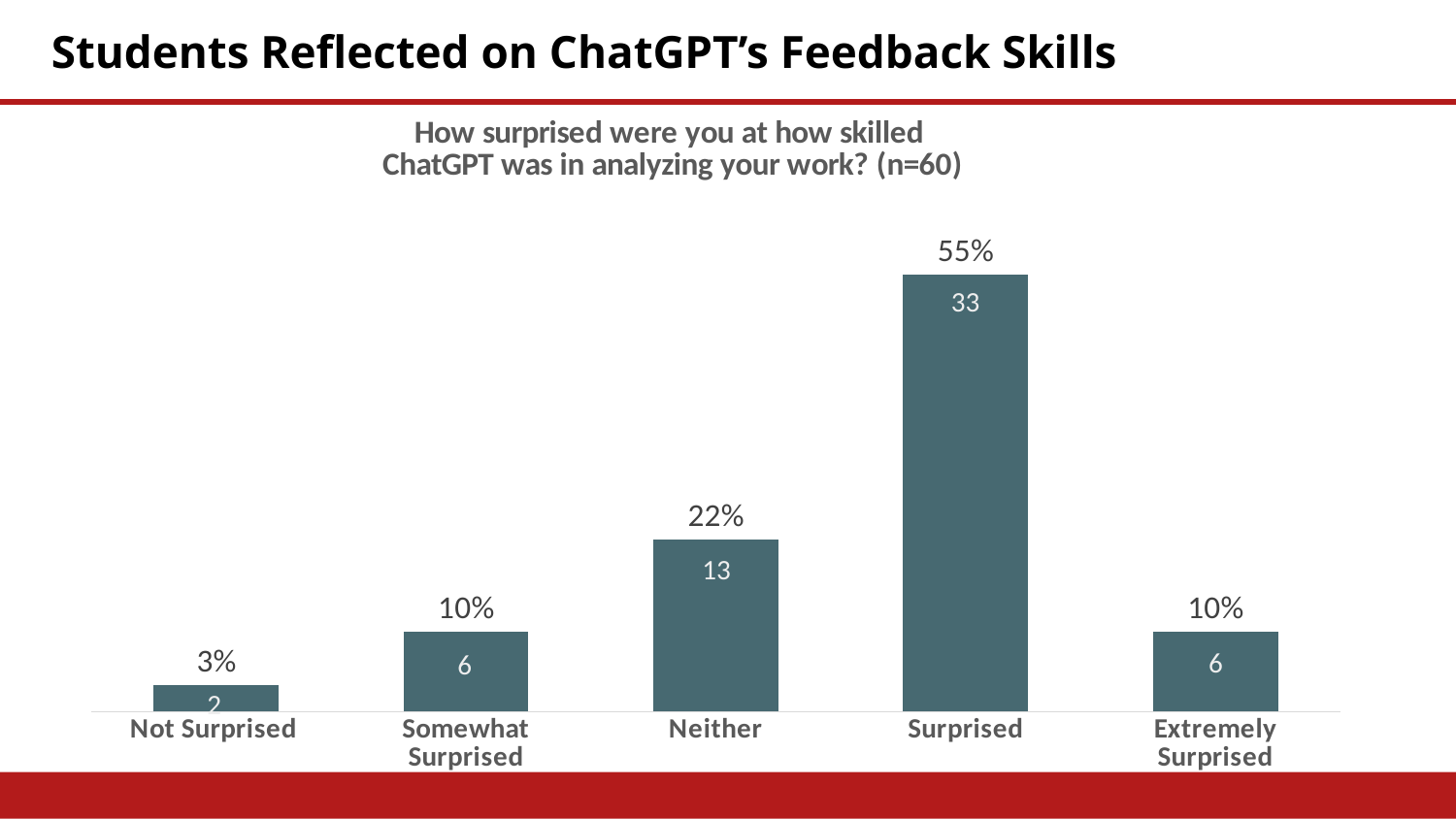
What is the sample size (n) stated in the chart title? 60 What percentage of students answered "Surprised"? 55% How many students answered "Somewhat Surprised"? 6 Which response category has the lowest value? Not Surprised Which response category has the highest value? Surprised How many students answered "Neither"? 13 What is the difference in percentage points between "Surprised" and "Neither"? 33 Which is larger, the value for "Neither" or the value for "Somewhat Surprised"? Neither What kind of chart is shown on the slide? Bar chart What percentage of students answered "Not Surprised"? 3% How many more students answered "Surprised" than "Extremely Surprised"? 27 How many response categories are shown on the chart? 5